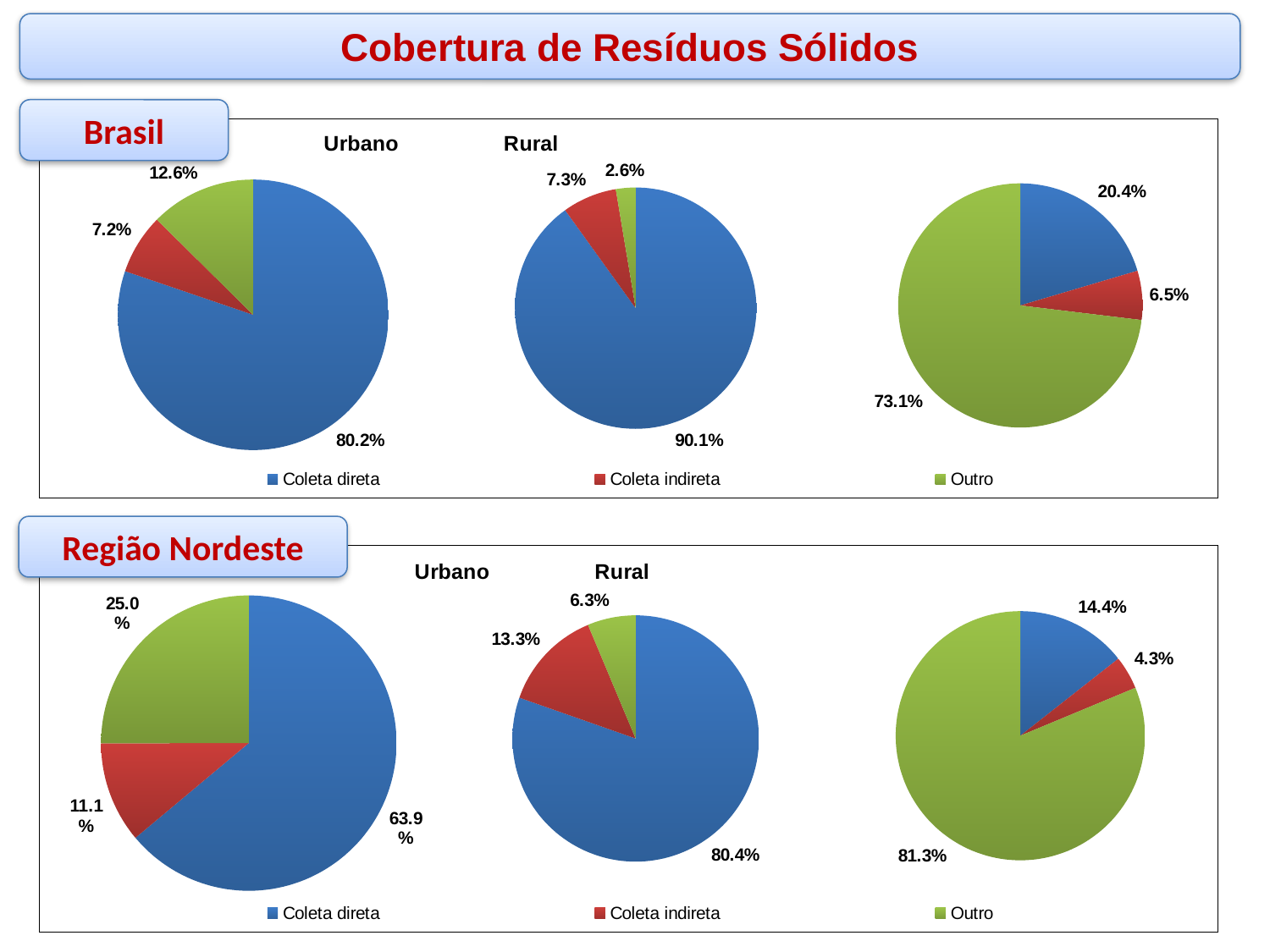
In the Região Nordeste row, what share does Coleta direta have in the rightmost pie chart? 14.4% In the Brasil row, what share does Coleta direta have in the leftmost pie chart? 80.2% How many categories does the legend list for the Brasil row of charts? 3 In the Brasil row, what share does Outro have in the middle pie chart? 2.6% In the Brasil row, which category has the largest slice in the rightmost pie chart? Outro In the Região Nordeste row, what share does Coleta indireta have in the middle pie chart? 13.3% In the Região Nordeste row, what share does Outro have in the leftmost pie chart? 25.0% In the Região Nordeste row, which category has the smallest slice in the rightmost pie chart? Coleta indireta What kind of charts are shown on the slide? Pie charts Which middle pie chart has the larger Coleta indireta share, the one in the Brasil row or the one in the Região Nordeste row? Região Nordeste How much larger is the Coleta direta share in the leftmost Brasil pie chart than in the leftmost Região Nordeste pie chart? 16.3 percentage points In the Brasil row, what share does Outro have in the rightmost pie chart? 73.1%